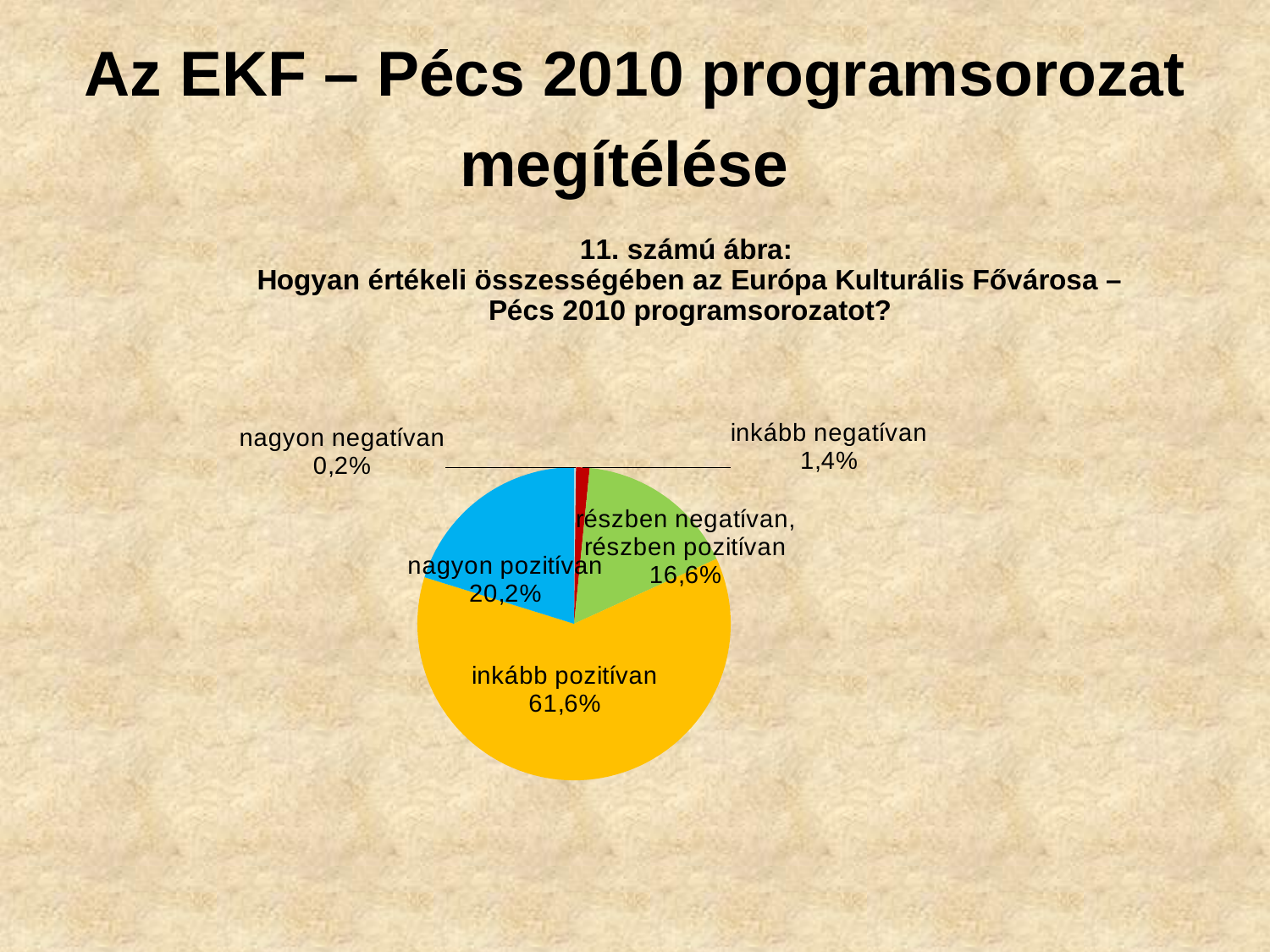
What percentage of respondents answered "inkább pozitívan"? 61,6% Which category has the largest share of the pie? inkább pozitívan What percentage of respondents answered "részben negatívan, részben pozitívan"? 16,6% How many slices does the pie chart have? 5 What percentage of respondents answered "nagyon negatívan"? 0,2% Which is larger: the share for "nagyon pozitívan" or for "részben negatívan, részben pozitívan"? nagyon pozitívan What is the figure number given in the chart caption? 11. számú ábra What percentage of respondents answered "inkább negatívan"? 1,4% What is the difference in percentage points between "inkább pozitívan" and "nagyon pozitívan"? 41,4 Which category has the smallest share of the pie? nagyon negatívan What kind of chart is shown on the slide? pie chart What percentage of respondents answered "nagyon pozitívan"? 20,2%